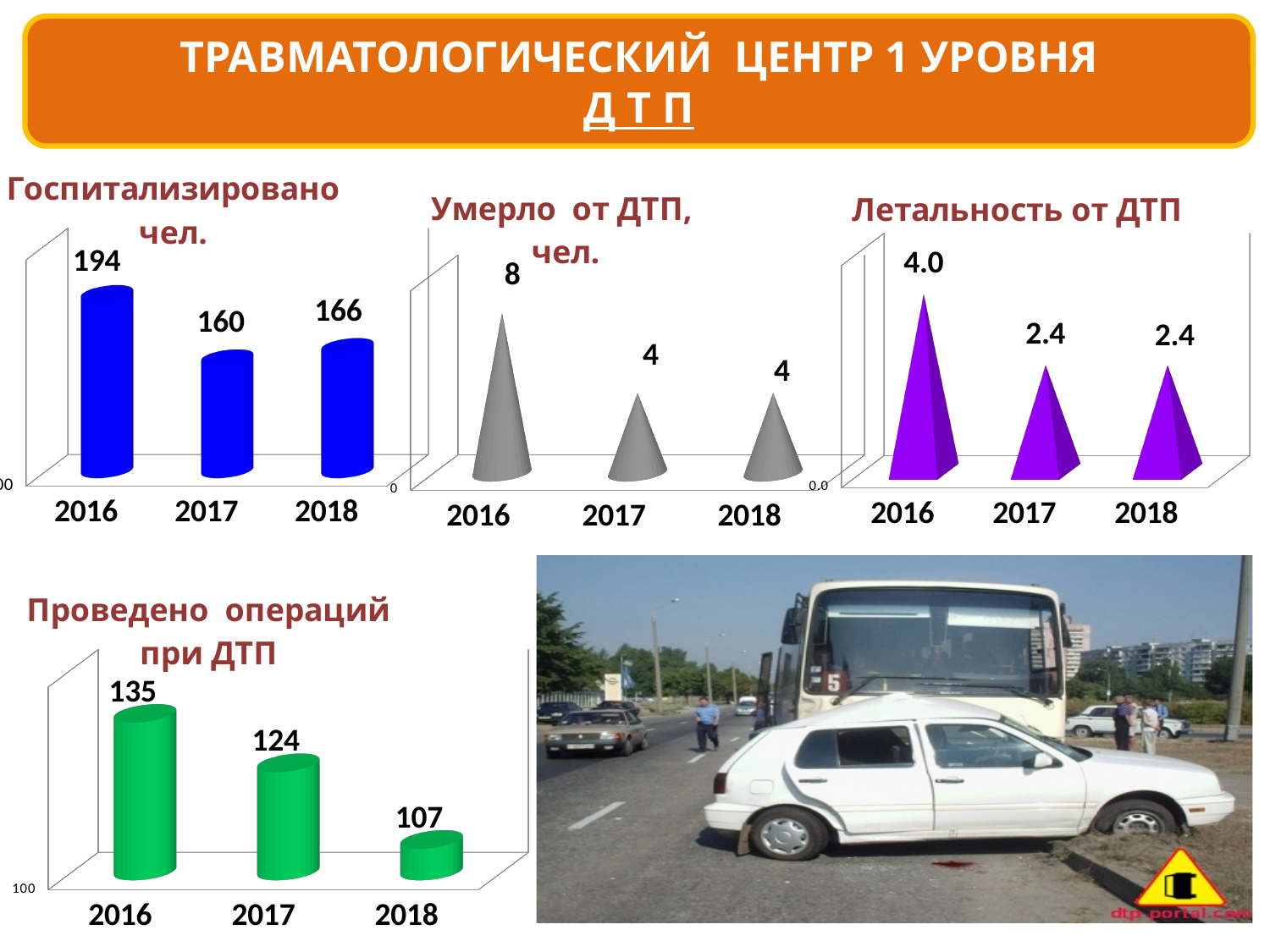
In the chart titled "Умерло от ДТП, чел.", what is the value for 2016? 8 In the chart titled "Госпитализировано чел.", which year has the lowest value? 2017 In the chart titled "Летальность от ДТП", what is the value for 2017? 2.4 In the chart titled "Госпитализировано чел.", what is the difference between the values for 2016 and 2018? 28 In the chart titled "Проведено операций при ДТП", what is the value for 2018? 107 In the chart titled "Проведено операций при ДТП", which is larger, the value for 2016 or the value for 2017? 2016 How many categories (years) are shown in the chart titled "Госпитализировано чел."? 3 What kind of chart is the one titled "Проведено операций при ДТП"? bar chart In the chart titled "Умерло от ДТП, чел.", which year has the highest value? 2016 In the chart titled "Проведено операций при ДТП", do the values rise or fall from 2016 to 2018? fall In the chart titled "Летальность от ДТП", what is the difference between the values for 2016 and 2018? 1.6 In the chart titled "Госпитализировано чел.", what is the value for 2016? 194